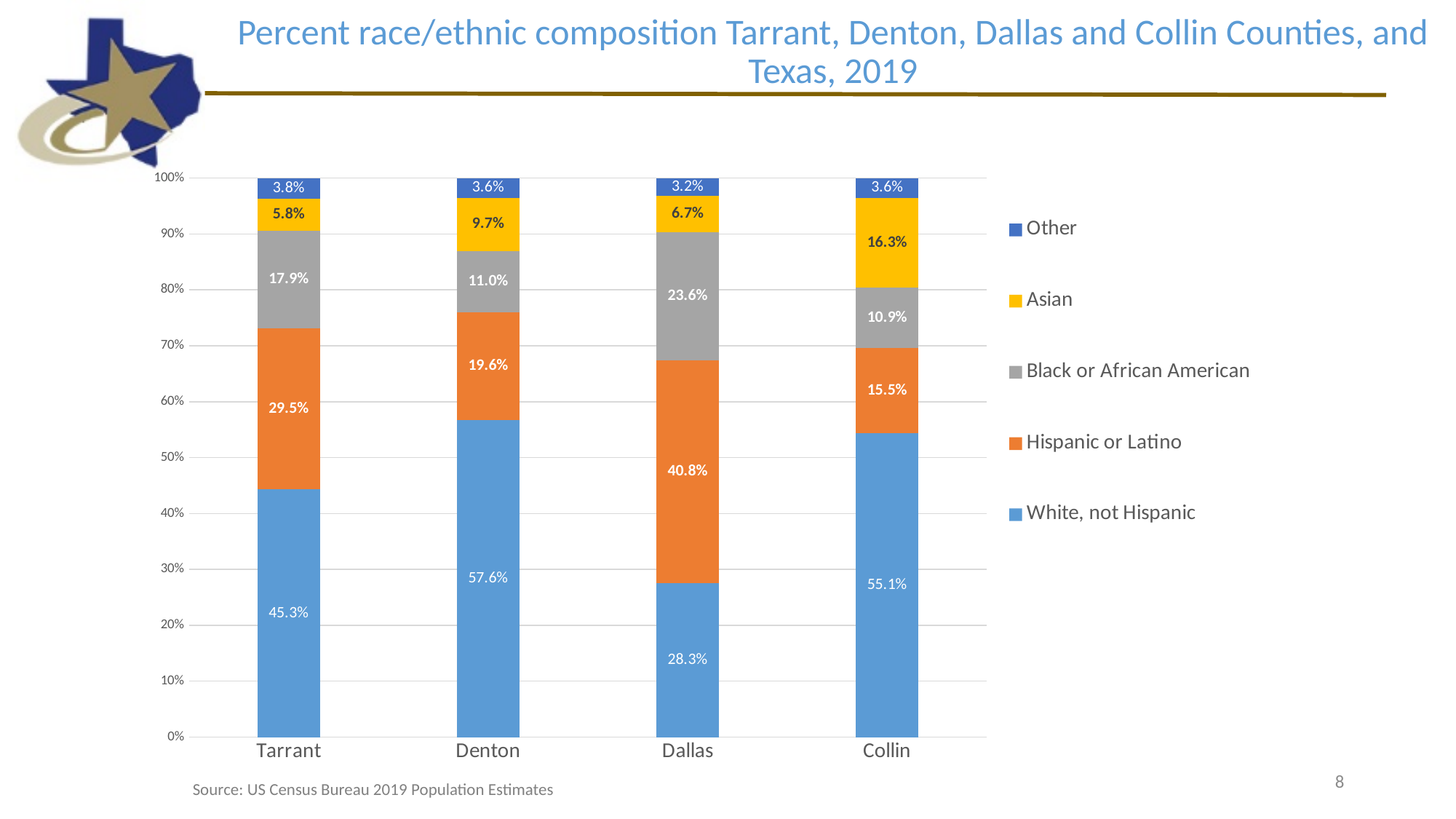
How many series does the legend list? 5 What is the Hispanic or Latino percentage for Denton? 19.6% What is the difference between the Hispanic or Latino percentages for Dallas and Tarrant? 11.3% What kind of chart is shown on the slide? Stacked bar chart Which county has the highest White, not Hispanic percentage? Denton How many counties are shown on the x axis of the chart? 4 Which is larger, the Asian percentage for Denton or for Dallas? Denton What is the Asian percentage for Collin? 16.3% What is the White, not Hispanic percentage for Dallas? 28.3% What is the Black or African American percentage for Tarrant? 17.9% Which legend entry is shown in orange? Hispanic or Latino Which county has the lowest Other percentage? Dallas